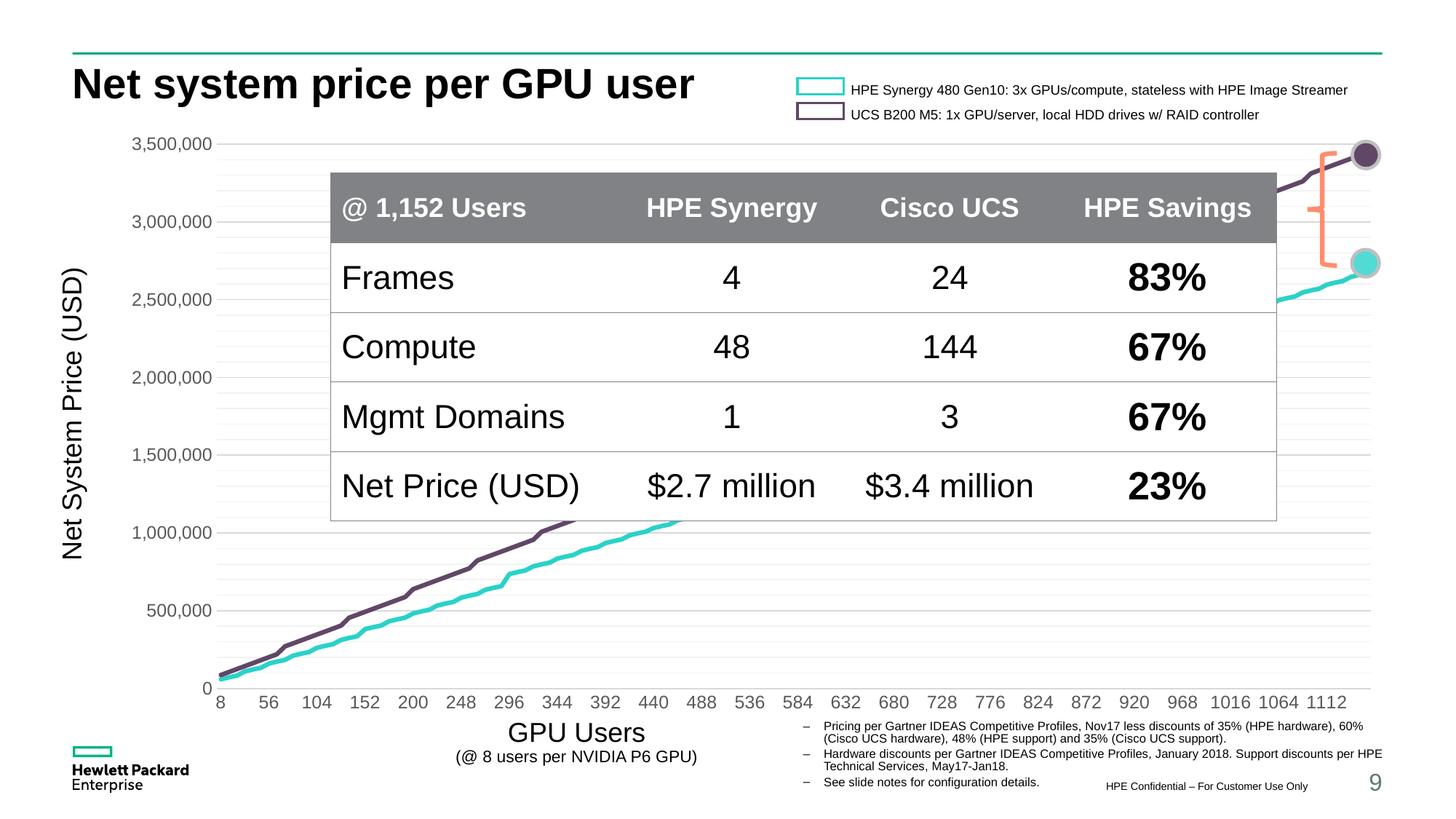
What kind of chart is shown on the slide? Line chart Does the net system price for UCS B200 M5 rise or fall as the number of GPU users increases? Rise Is the net system price for HPE Synergy 480 Gen10 at 104 GPU users greater or less than 500,000? less According to the table, what is the net price for Cisco UCS at 1,152 users? $3.4 million According to the table, what is the net price for HPE Synergy at 1,152 users? $2.7 million Is the net system price for UCS B200 M5 at 1112 GPU users greater or less than 3,000,000? greater What is the title of the chart? Net system price per GPU user At 1112 GPU users, which series has the higher net system price, HPE Synergy 480 Gen10 or UCS B200 M5? UCS B200 M5 What is the label of the y axis? Net System Price (USD) How many series does the legend list? 2 Is the net system price for UCS B200 M5 at 296 GPU users greater or less than 500,000? greater According to the table, what is the HPE savings percentage on net price at 1,152 users? 23%